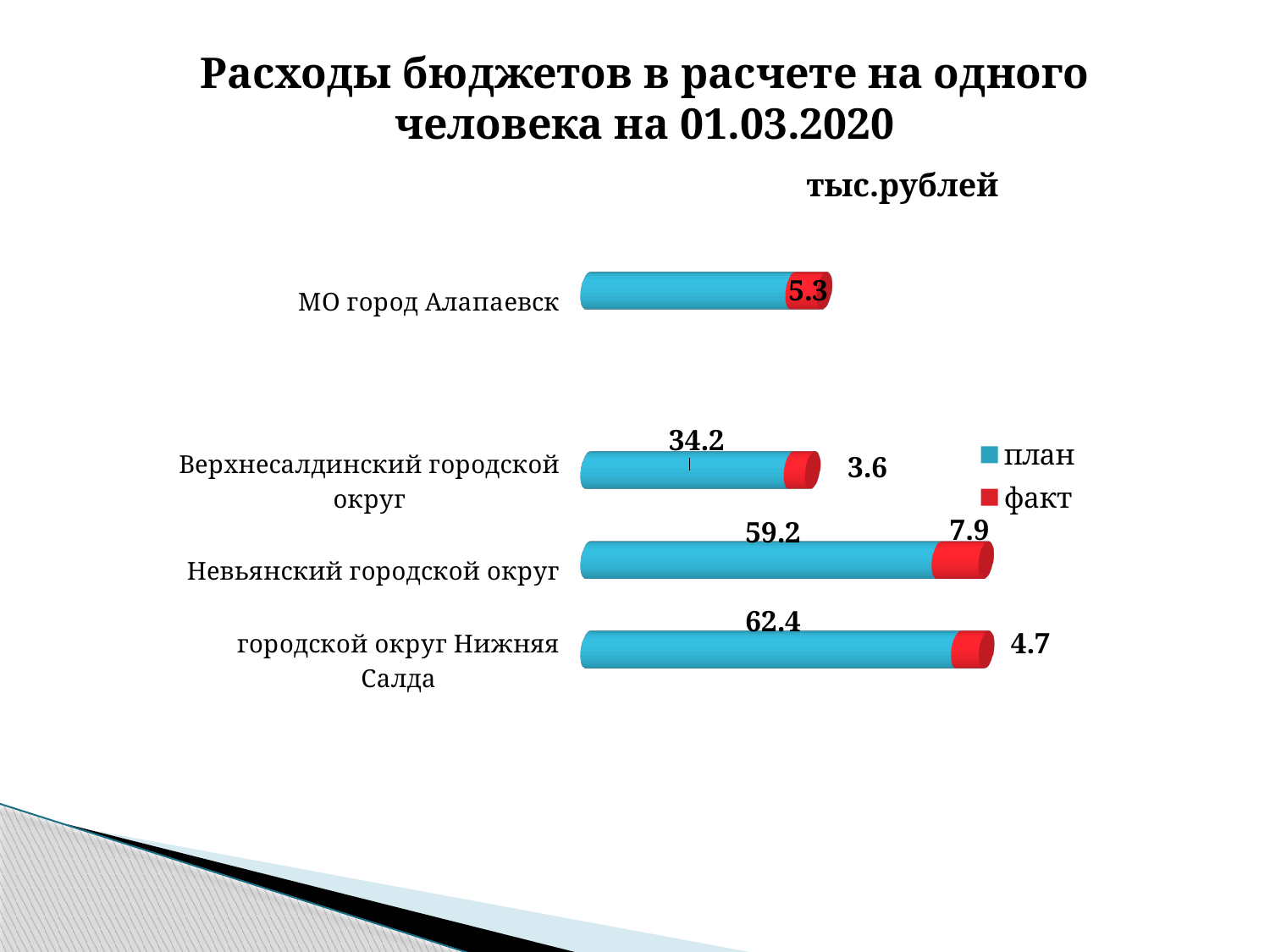
Which is larger: the план value for Верхнесалдинский городской округ or the план value for Невьянский городской округ? Невьянский городской округ How many categories are shown on the chart? 4 Which category has the lowest факт value? Верхнесалдинский городской округ What is the план value for городской округ Нижняя Салда? 62.4 How many series does the legend list? 2 What kind of chart is shown on the slide? Bar chart What is the difference between the факт values for Невьянский городской округ and Верхнесалдинский городской округ? 4.3 What is the факт value for МО город Алапаевск? 5.3 What is the факт value for Верхнесалдинский городской округ? 3.6 Which category has the highest факт value? Невьянский городской округ What is the план value for Невьянский городской округ? 59.2 What is the difference between the план values for городской округ Нижняя Салда and Невьянский городской округ? 3.2